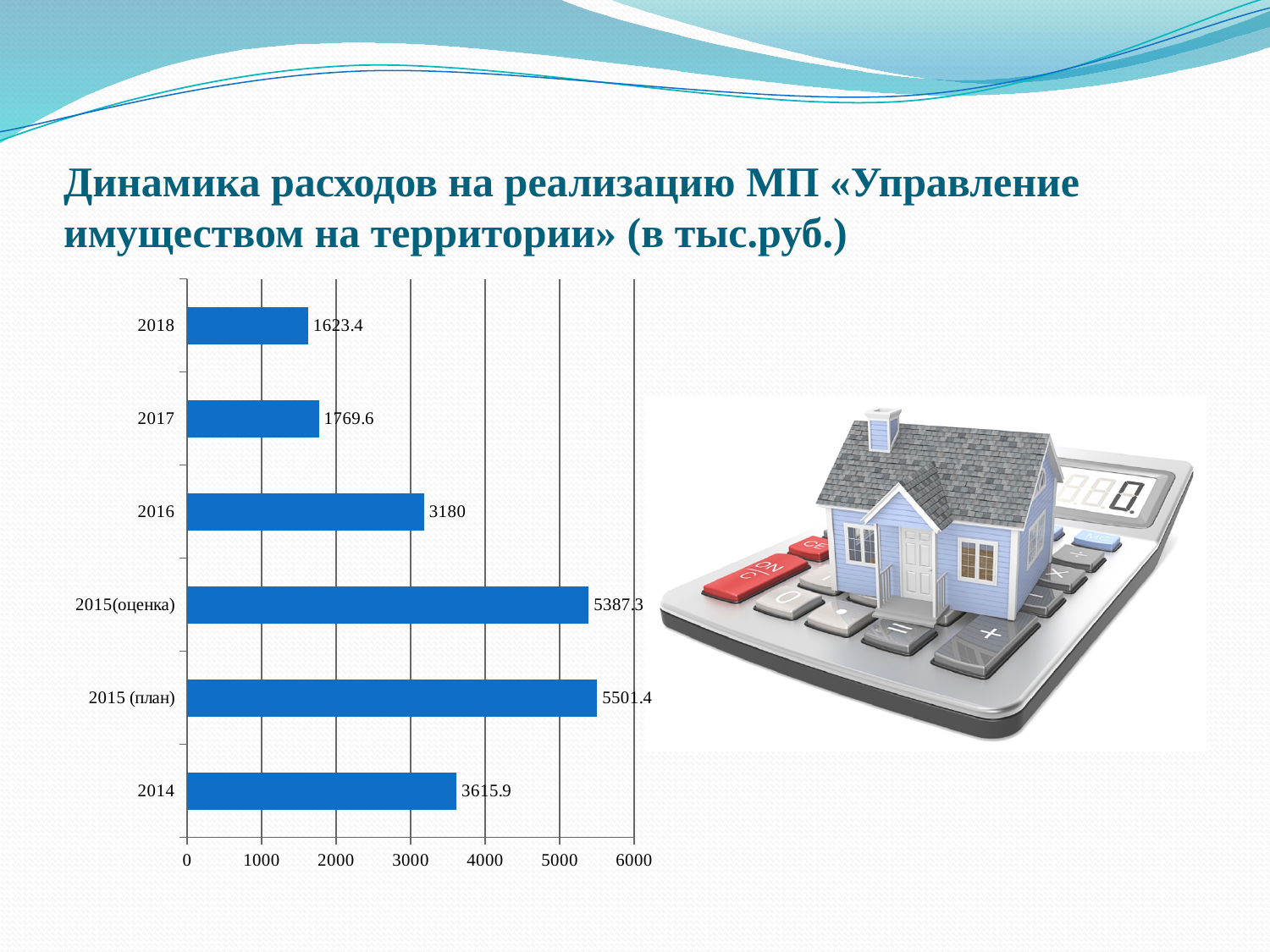
What is the value for 2018? 1623.4 How many categories are shown on the chart? 6 Which category has the lowest value? 2018 What is the value for 2016? 3180 What kind of chart is shown on the slide? bar chart What is the difference between the values for 2017 and 2018? 146.2 What is the value for 2014? 3615.9 What is the difference between the values for 2015 (план) and 2015(оценка)? 114.1 Which category has the highest value? 2015 (план) Which is larger, the value for 2014 or the value for 2016? 2014 What is the value for 2015 (план)? 5501.4 Is the value for 2017 greater or less than 2000? less